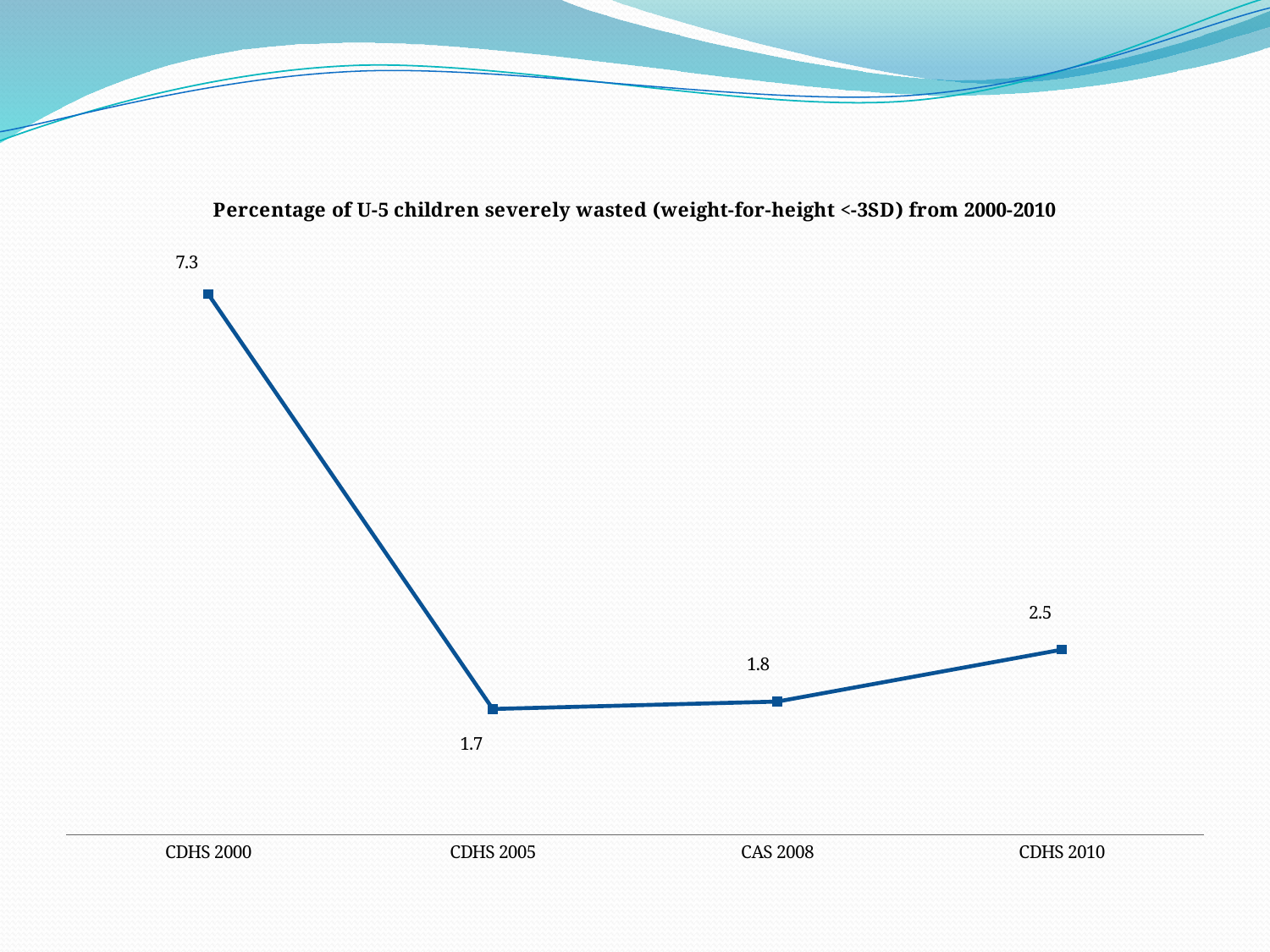
How many data points are plotted on the chart? 4 Which survey has the lowest percentage of severely wasted children? CDHS 2005 What is the difference between the values for CDHS 2010 and CAS 2008? 0.7 Which survey has the highest percentage of severely wasted children? CDHS 2000 What is the value for CDHS 2005? 1.7 What is the value for CAS 2008? 1.8 What is the title of the chart? Percentage of U-5 children severely wasted (weight-for-height <-3SD) from 2000-2010 What is the value for CDHS 2000? 7.3 What is the value for CDHS 2010? 2.5 Which is larger, the value for CDHS 2010 or the value for CDHS 2005? CDHS 2010 What is the difference between the values for CDHS 2000 and CDHS 2005? 5.6 What kind of chart is shown on the slide? Line chart